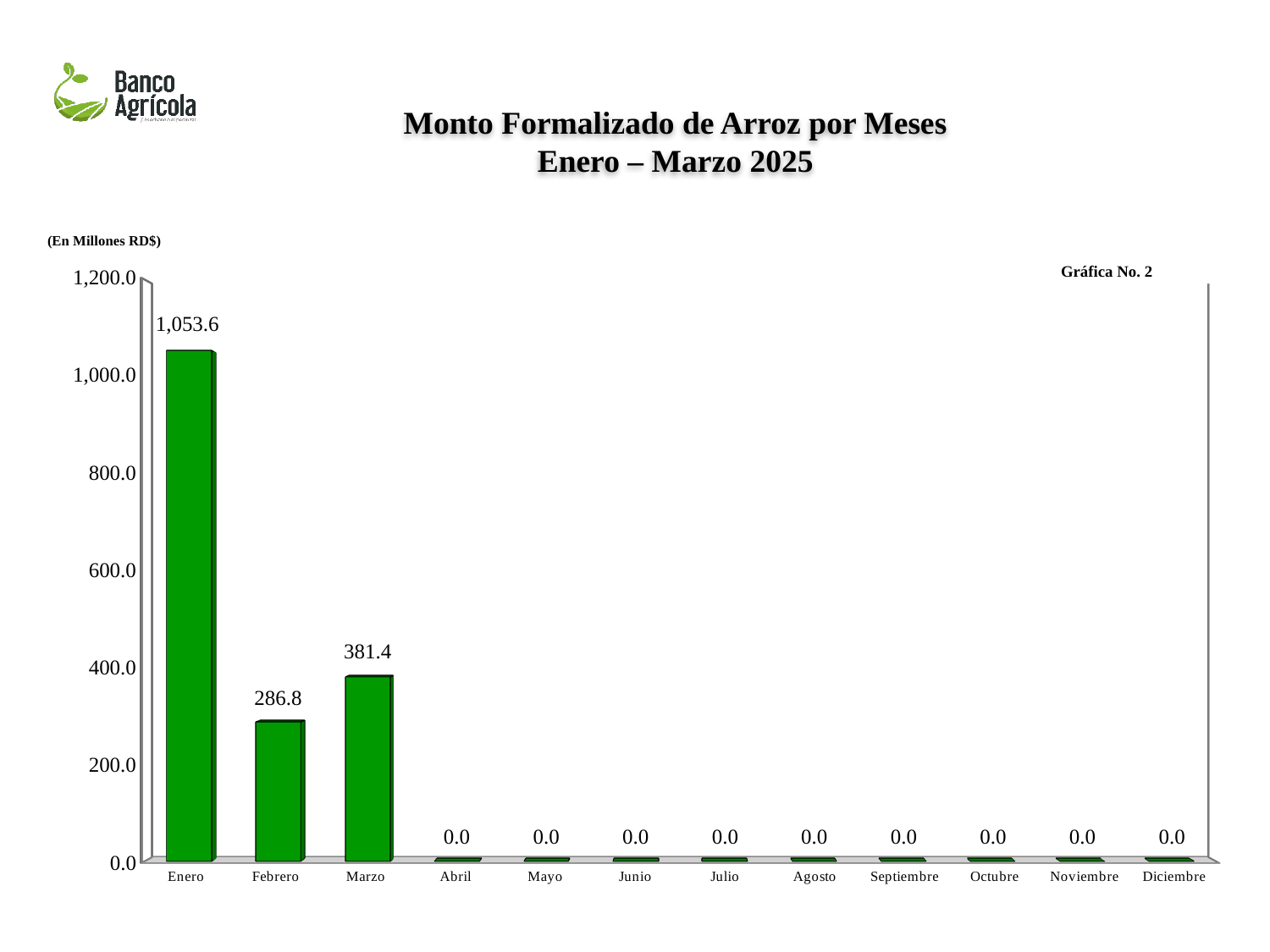
What is the value for Abril? 0.0 What kind of chart is shown on the slide? bar chart What is the difference between the values for Enero and Marzo? 672.2 What is the value for Febrero? 286.8 What is the difference between the values for Marzo and Febrero? 94.6 What is the value for Enero? 1,053.6 How many months are shown on the x axis? 12 Which month has the highest value? Enero Which is larger, the value for Febrero or the value for Marzo? Marzo What unit is stated for the values in the chart? En Millones RD$ Is the value for Enero greater or less than 1,000.0? greater What is the value for Marzo? 381.4